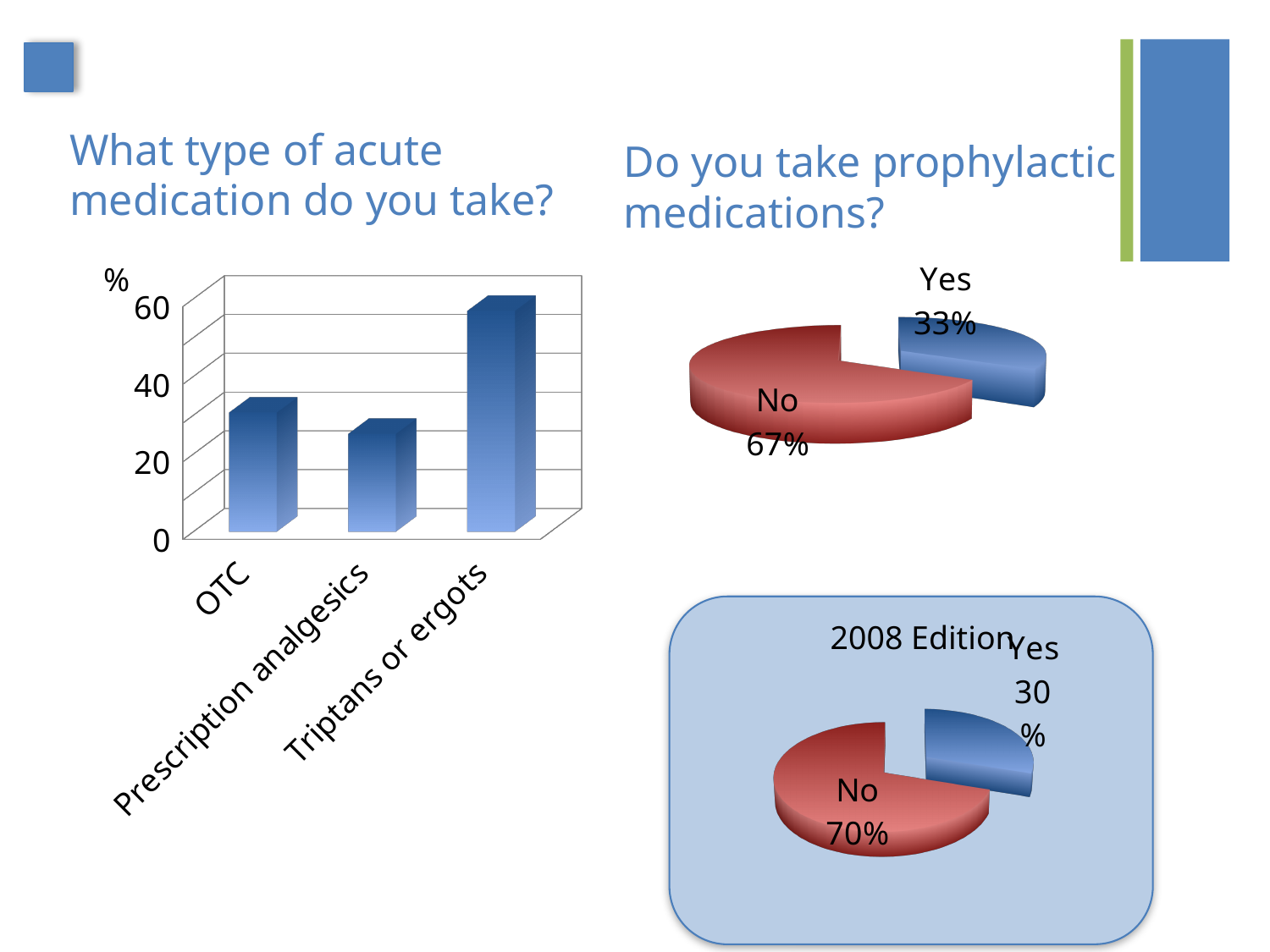
In the "What type of acute medication do you take?" bar chart, which category has the highest value? Triptans or ergots What kind of chart is the one titled "What type of acute medication do you take?"? bar chart In the "Do you take prophylactic medications?" pie chart, what share answered Yes? 33% In the "What type of acute medication do you take?" bar chart, which is larger, the value for OTC or the value for Triptans or ergots? Triptans or ergots In the "What type of acute medication do you take?" bar chart, which category has the lowest value? Prescription analgesics In the "2008 Edition" pie chart, what share answered No? 70% How many categories are shown in the "What type of acute medication do you take?" bar chart? 3 In the "What type of acute medication do you take?" bar chart, is the value for Triptans or ergots greater or less than 40? greater In the "2008 Edition" pie chart, what is the difference between the No share and the Yes share? 40% What kind of chart is the "2008 Edition" chart? pie chart In the "Do you take prophylactic medications?" pie chart, what share answered No? 67% In the "What type of acute medication do you take?" bar chart, is the value for Prescription analgesics greater or less than 40? less